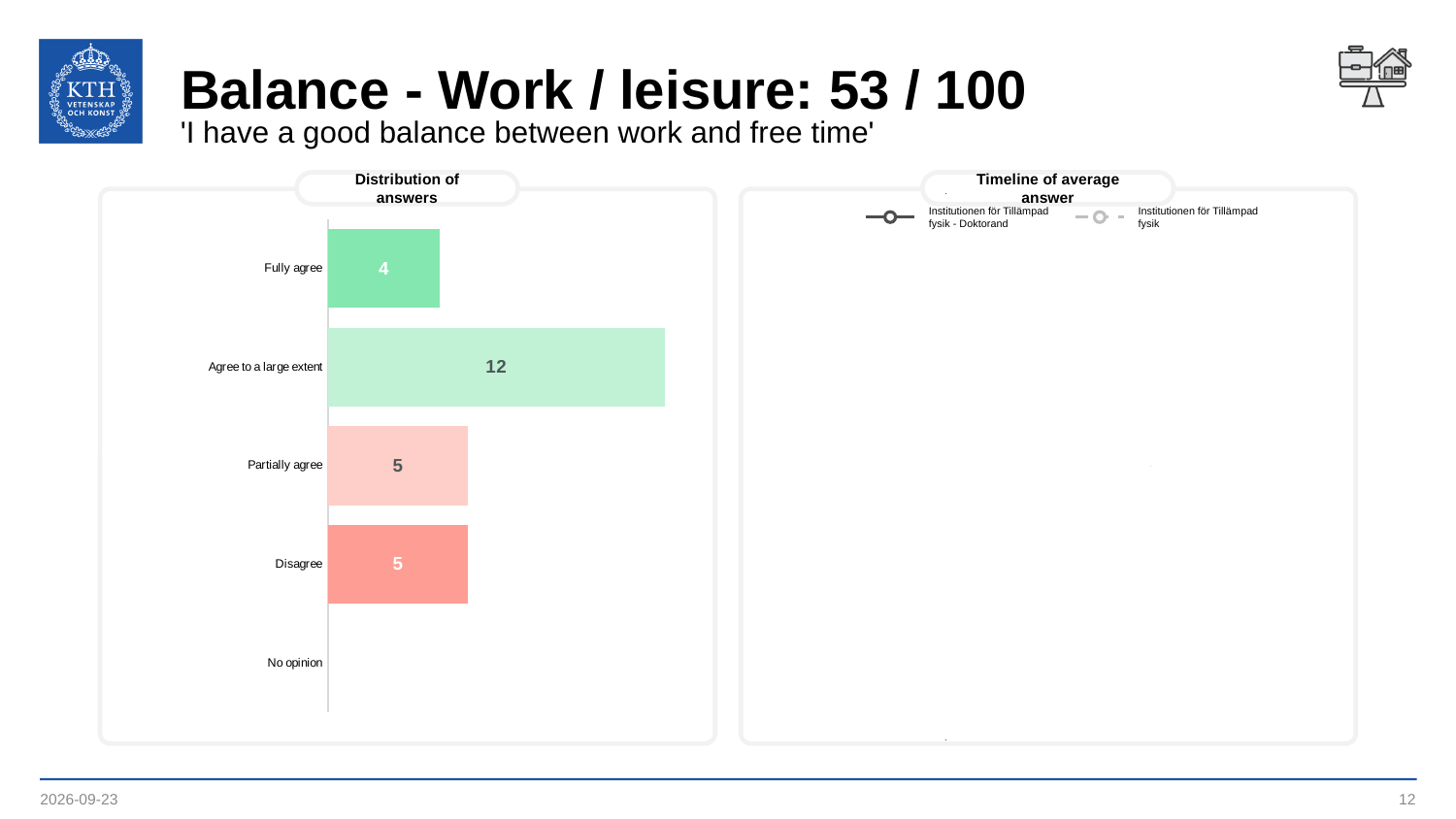
In the 'Distribution of answers' chart, what is the difference between 'Partially agree' and 'Fully agree'? 1 In the 'Distribution of answers' chart, how many respondents answered 'Agree to a large extent'? 12 In the 'Distribution of answers' chart, what is the difference between 'Agree to a large extent' and 'Fully agree'? 8 How many series does the legend of the 'Timeline of average answer' chart list? 2 In the 'Distribution of answers' chart, what is the value for 'Disagree'? 5 In the 'Distribution of answers' chart, what is the combined total of 'Partially agree' and 'Disagree'? 10 What kind of chart is the 'Distribution of answers' chart? Bar chart What is the title of the chart on the left side of the slide? Distribution of answers In the 'Distribution of answers' chart, which is larger: 'Partially agree' or 'Fully agree'? Partially agree In the 'Distribution of answers' chart, which answer category has the highest value? Agree to a large extent How many answer categories are listed on the y axis of the 'Distribution of answers' chart? 5 In the 'Distribution of answers' chart, what is the value for 'Fully agree'? 4